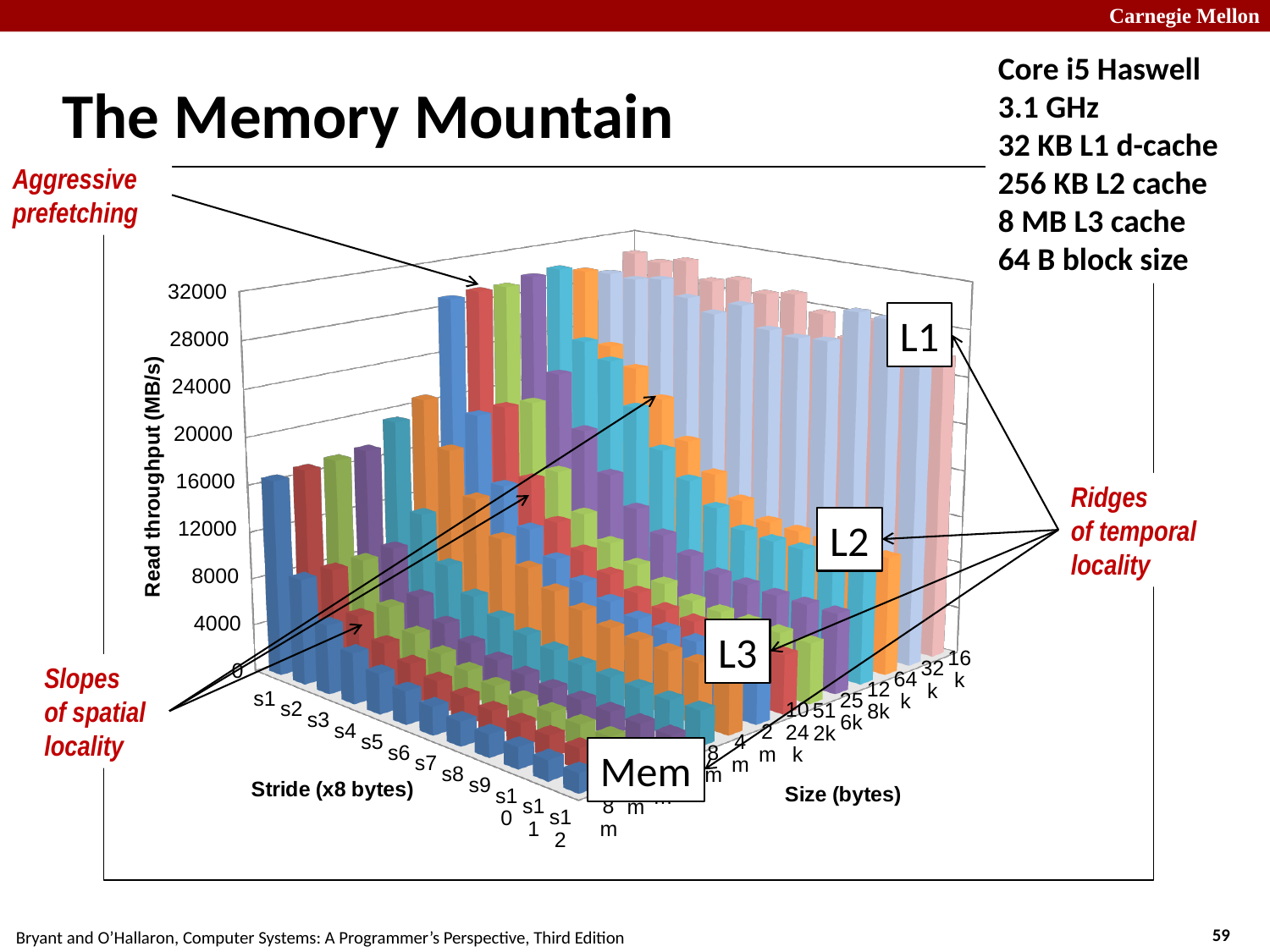
What is the label of the vertical axis of the chart? Read throughput (MB/s) How many stride categories are shown along the stride axis of the chart? 12 What kind of chart is shown on the slide? 3D bar chart For a given stride, does read throughput rise or fall as the working-set size increases from 16k toward 128m? fall For a given size, does read throughput rise or fall as the stride increases from s1 to s12? fall What is the title of the chart on the slide? The Memory Mountain Which region of the chart has the highest read throughput: the L1 ridge or the Mem region? L1 Which labelled region of the chart has the lowest read throughput? Mem